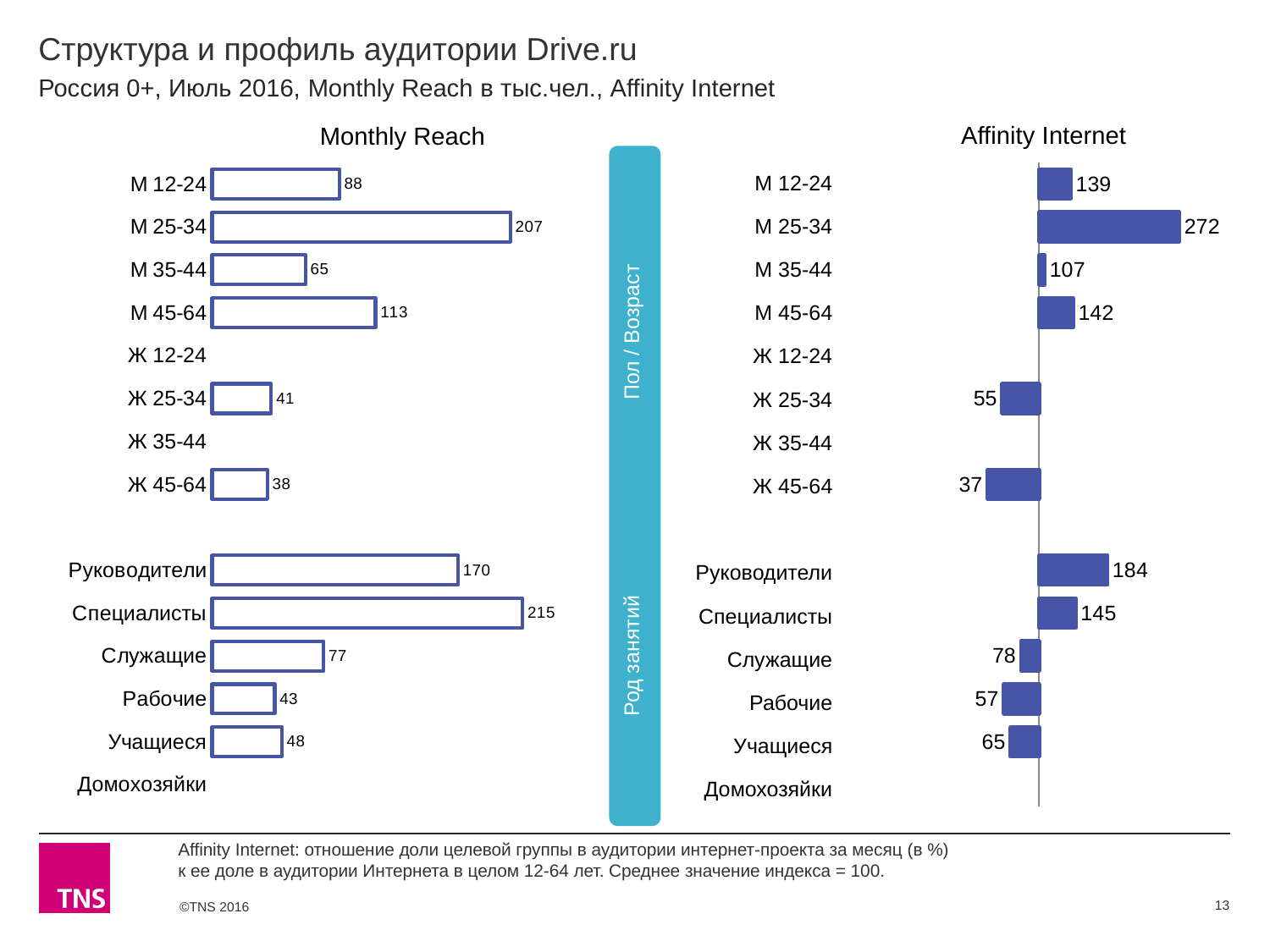
In the Monthly Reach chart, what is the value for М 25-34? 207 In the Affinity Internet chart, which category has the lowest labelled value? Ж 45-64 What kind of chart is the Monthly Reach chart? Bar chart In the Monthly Reach chart, what is the difference between the values for Специалисты and Руководители? 45 In the Affinity Internet chart, what is the value for М 35-44? 107 In the Monthly Reach chart, which is larger: the value for М 45-64 or the value for М 12-24? М 45-64 In the Affinity Internet chart, what is the difference between the values for М 25-34 and М 12-24? 133 In the Affinity Internet chart, what is the value for Руководители? 184 In the Monthly Reach chart, what is the value for Рабочие? 43 In the Monthly Reach chart, which category has the highest value? Специалисты In the Affinity Internet chart, which is larger: the value for Служащие or the value for Учащиеся? Служащие In the Monthly Reach chart, what is the value for Ж 45-64? 38